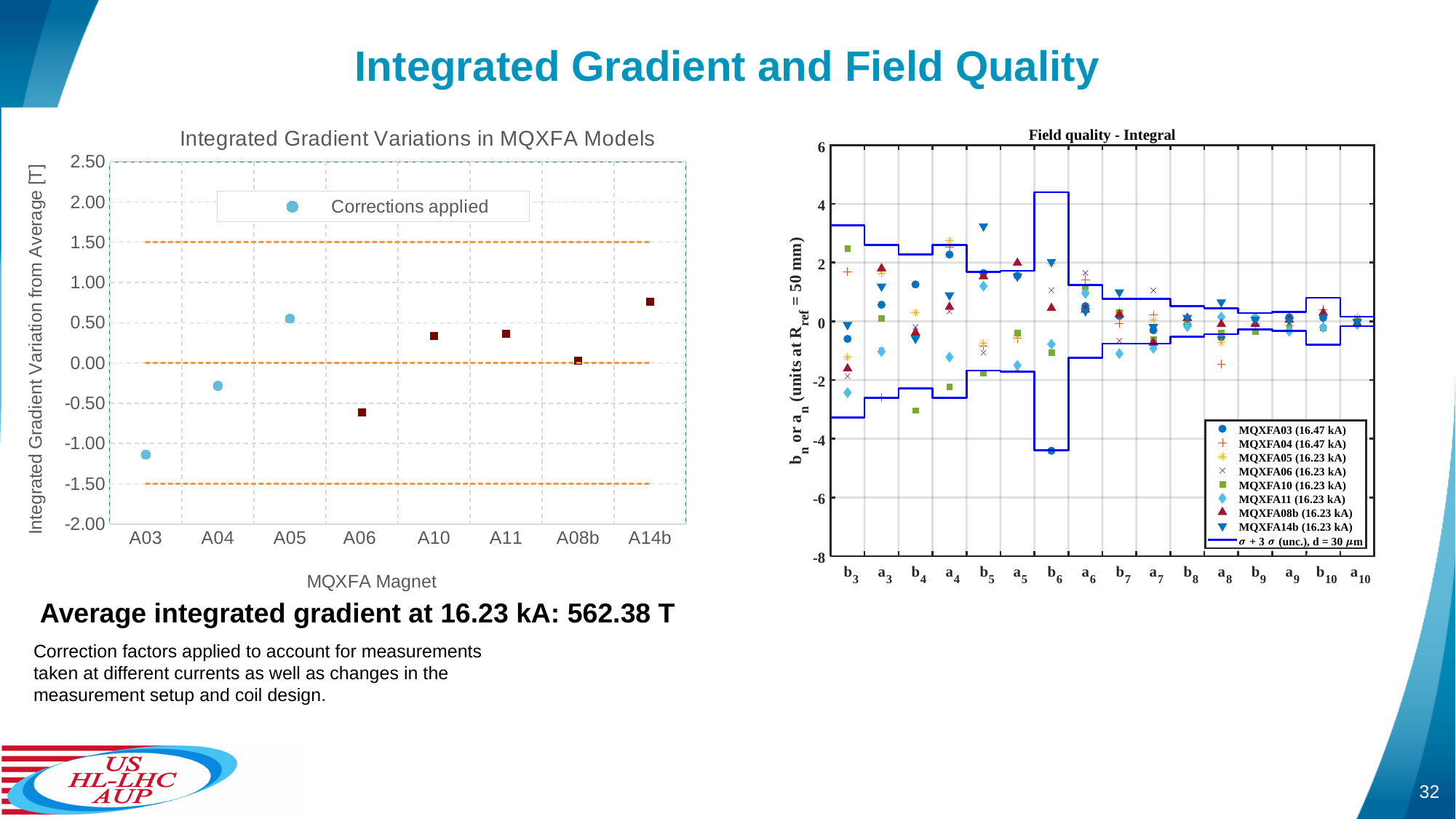
In the 'Integrated Gradient Variations in MQXFA Models' chart, is the value for A03 greater or less than -1.00? less In the 'Field quality - Integral' chart, how many harmonic categories are shown on the x axis? 16 In the 'Integrated Gradient Variations in MQXFA Models' chart, how many magnets are plotted on the x axis? 8 In the 'Integrated Gradient Variations in MQXFA Models' chart, which has the larger value, A05 or A06? A05 In the 'Integrated Gradient Variations in MQXFA Models' chart, which magnet has the highest integrated gradient variation? A14b In the 'Integrated Gradient Variations in MQXFA Models' chart, which magnet has the lowest integrated gradient variation? A03 What type of chart is the 'Integrated Gradient Variations in MQXFA Models' chart? scatter chart In the 'Integrated Gradient Variations in MQXFA Models' chart, what is the label of the x axis? MQXFA Magnet In the 'Field quality - Integral' chart, what current is listed in the legend for MQXFA03? 16.47 kA In the 'Integrated Gradient Variations in MQXFA Models' chart, is the value for A06 greater or less than -0.50? less In the 'Field quality - Integral' chart, how many entries does the legend list? 9 In the 'Integrated Gradient Variations in MQXFA Models' chart, is the value for A14b greater or less than 0.50? greater